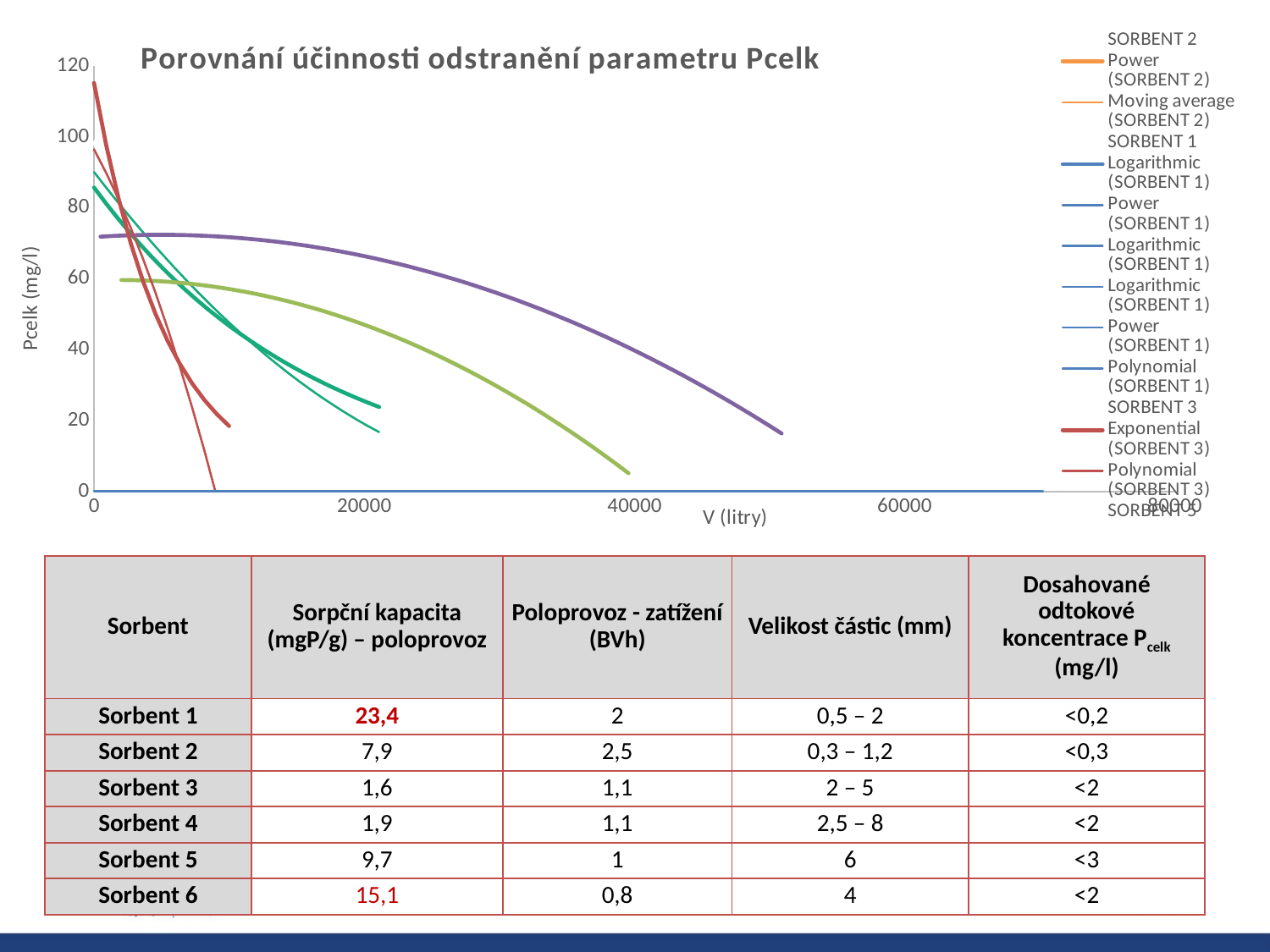
What is the title of the chart? Porovnání účinnosti odstranění parametru Pcelk Do the plotted curves rise or fall as V (litry) increases? fall Is the value of the purple curve at V = 0 greater or less than 60? greater Is the starting value of the red Exponential (SORBENT 3) curve at V = 0 greater or less than 100? greater Which curve extends furthest along the V (litry) axis: the purple curve or the red Exponential (SORBENT 3) curve? the purple curve Is the value of the purple curve at its right-hand end (around V = 50000) greater or less than 20? less What is the label of the chart's vertical axis? Pcelk (mg/l) What kind of chart is shown on the slide? line chart At V = 0, which curve has the higher value: the red Exponential (SORBENT 3) curve or the purple curve? the red Exponential (SORBENT 3) curve